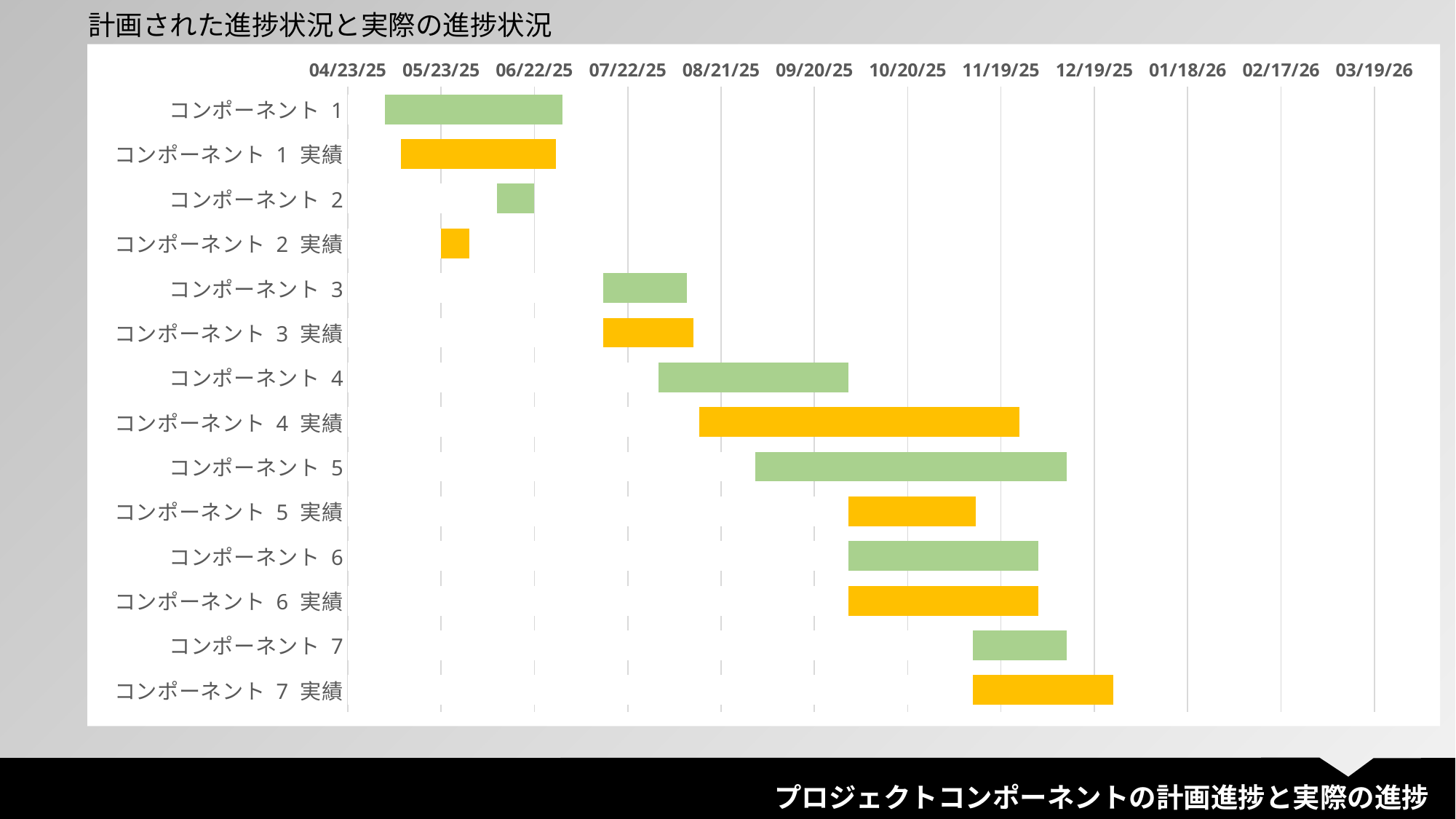
What kind of chart is shown on the slide? Bar chart (Gantt chart) Which bar is longer: コンポーネント 5 or コンポーネント 5 実績? コンポーネント 5 What is the first date label shown on the horizontal axis? 04/23/25 Which bar is longer: コンポーネント 1 or コンポーネント 2? コンポーネント 1 What colour are the bars for the 実績 (actual) rows? Orange/yellow Does the bar for コンポーネント 4 実績 end before or after 11/19/25? after How many category rows are listed on the vertical axis of the chart? 14 Does the bar for コンポーネント 1 start before or after 05/23/25? before Does the bar for コンポーネント 3 start before or after 07/22/25? before Which category has the shortest bar in the chart? コンポーネント 2 実績 What is the title of the chart? 計画された進捗状況と実際の進捗状況